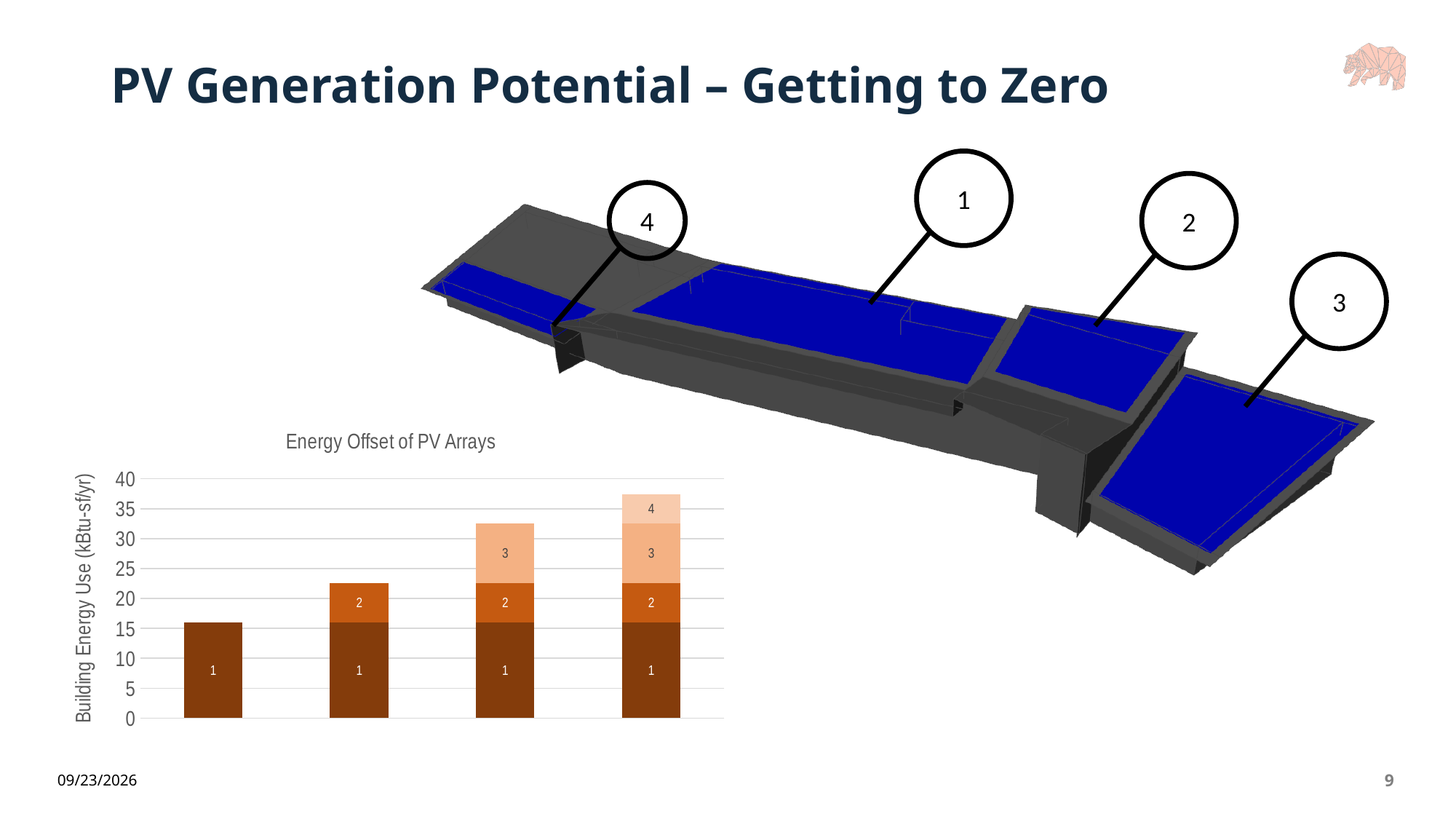
In the "Energy Offset of PV Arrays" chart, which bar has the highest total? The rightmost (fourth) bar What is the label of the vertical axis in the "Energy Offset of PV Arrays" chart? Building Energy Use (kBtu-sf/yr) In the "Energy Offset of PV Arrays" chart, do the bar totals rise or fall from left to right? Rise What is the title of the chart on the slide? Energy Offset of PV Arrays In the "Energy Offset of PV Arrays" chart, is the total of the leftmost bar greater or less than 20? less What kind of chart is shown under the title "Energy Offset of PV Arrays"? Stacked bar chart In the "Energy Offset of PV Arrays" chart, is the total of the third bar greater or less than 30? greater In the "Energy Offset of PV Arrays" chart, is the total of the rightmost bar greater or less than 35? greater In the "Energy Offset of PV Arrays" chart, which bar has the lowest total? The leftmost (first) bar How many stacked segments make up the rightmost bar in the "Energy Offset of PV Arrays" chart? 4 How many bars are plotted in the "Energy Offset of PV Arrays" chart? 4 In the "Energy Offset of PV Arrays" chart, which has the larger total, the second bar or the third bar? The third bar